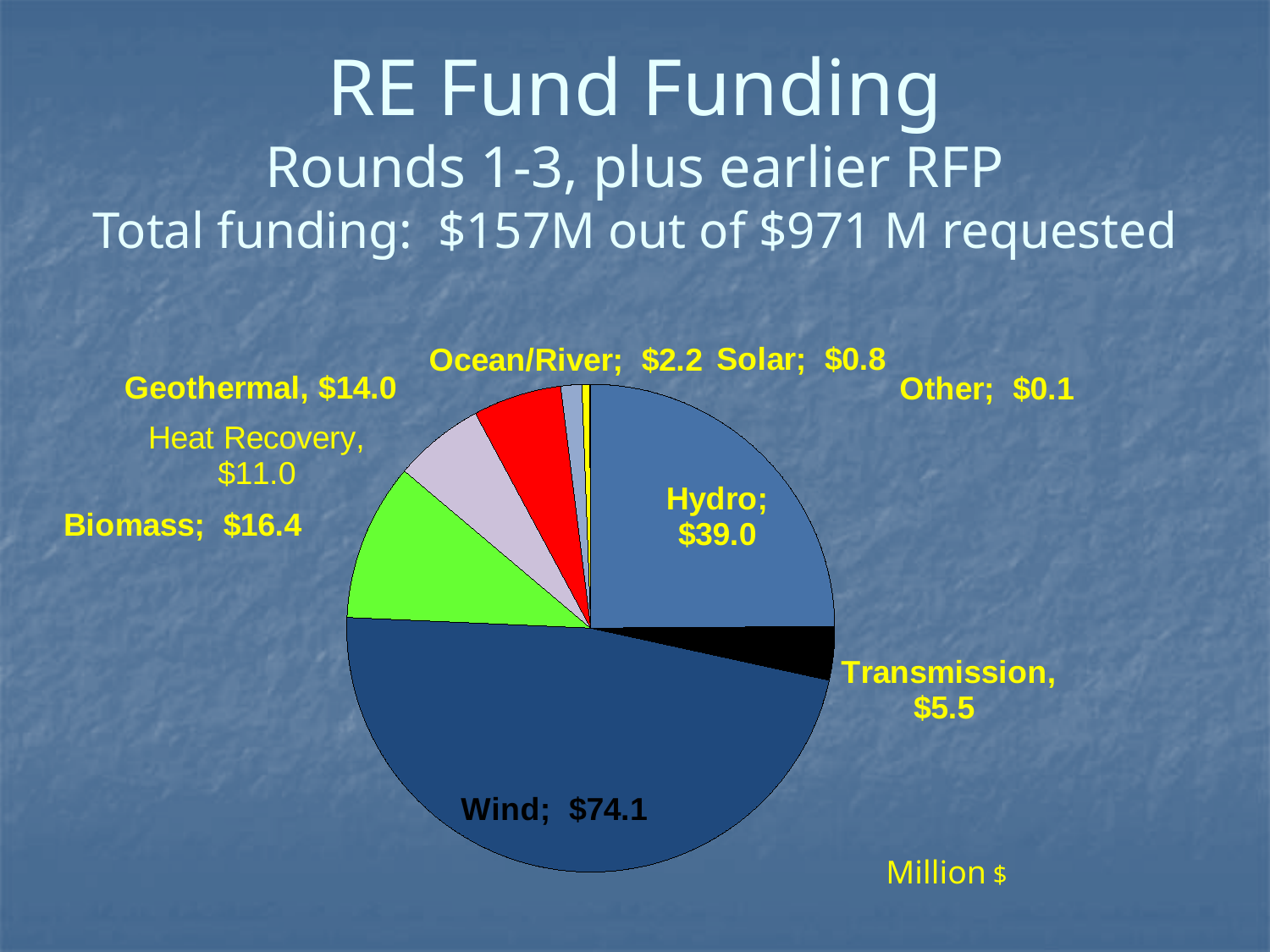
What is the funding value for Transmission? $5.5 What is the funding value for Wind? $74.1 Which category received the least funding? Other In what units are the values in the chart expressed? Million $ What is the difference between the Geothermal and Heat Recovery funding values? $3.0 Which category received the most funding? Wind Which received more funding, Biomass or Geothermal? Biomass What is the funding value for Heat Recovery? $11.0 What is the difference between the Wind and Hydro funding values? $35.1 How many categories are shown in the pie chart? 9 What kind of chart is shown on the slide? pie chart What is the funding value for Hydro? $39.0